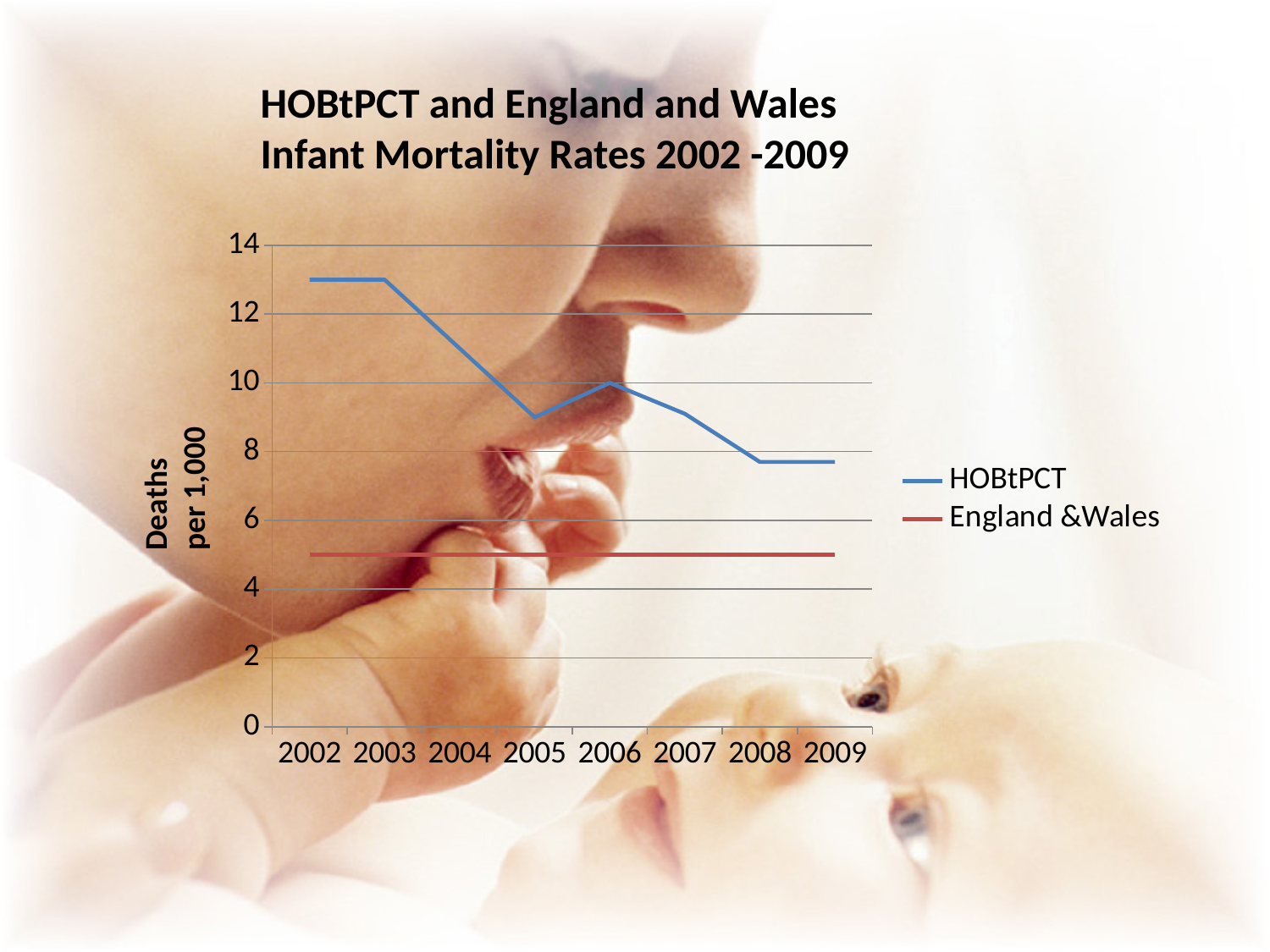
In 2009, which series has the higher value, HOBtPCT or England & Wales? HOBtPCT What is the label on the y axis? Deaths per 1,000 What kind of chart is shown on the slide? line chart Which series is drawn in red? England & Wales Is the HOBtPCT value for 2005 greater or less than 10? less Is the England & Wales value for 2002 greater or less than 6? less Is the HOBtPCT value for 2004 greater or less than 10? greater Does the HOBtPCT line generally rise or fall from 2002 to 2009? fall How many series does the legend list? 2 How many years are shown on the x axis? 8